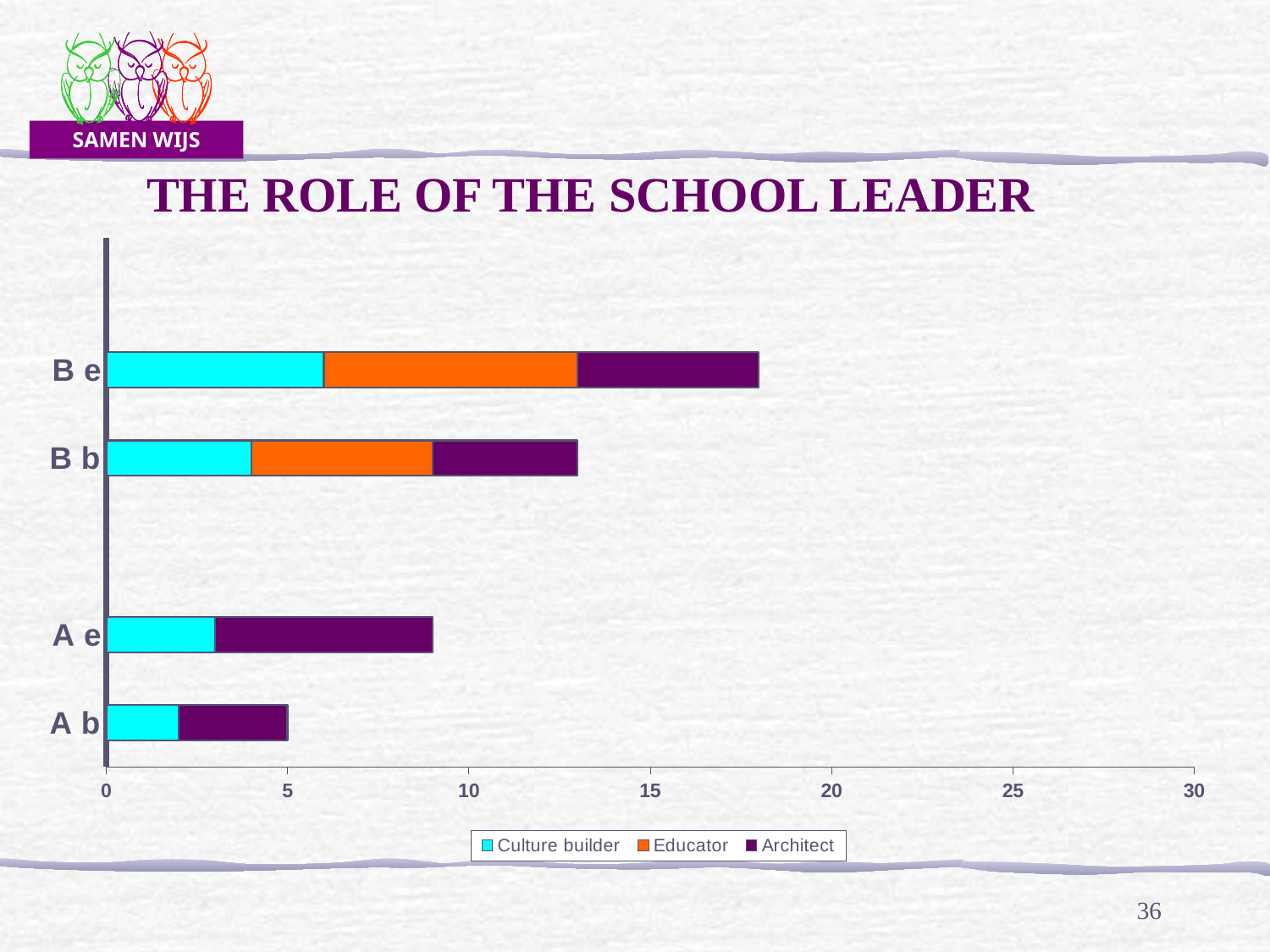
Is the total value for B e greater or less than 15? greater Is the total value for B b greater or less than 10? greater Which category has the longest total bar? B e Which has the larger total bar, A e or A b? A e What is the title of the chart on the slide? THE ROLE OF THE SCHOOL LEADER What kind of chart is shown on the slide? bar chart Which series is shown in orange in the chart's legend? Educator Is the total value for A e greater or less than 10? less Which category has the shortest total bar? A b How many series does the chart's legend list? 3 How many categories are shown on the vertical axis of the chart? 4 Which has the larger total bar, B e or B b? B e